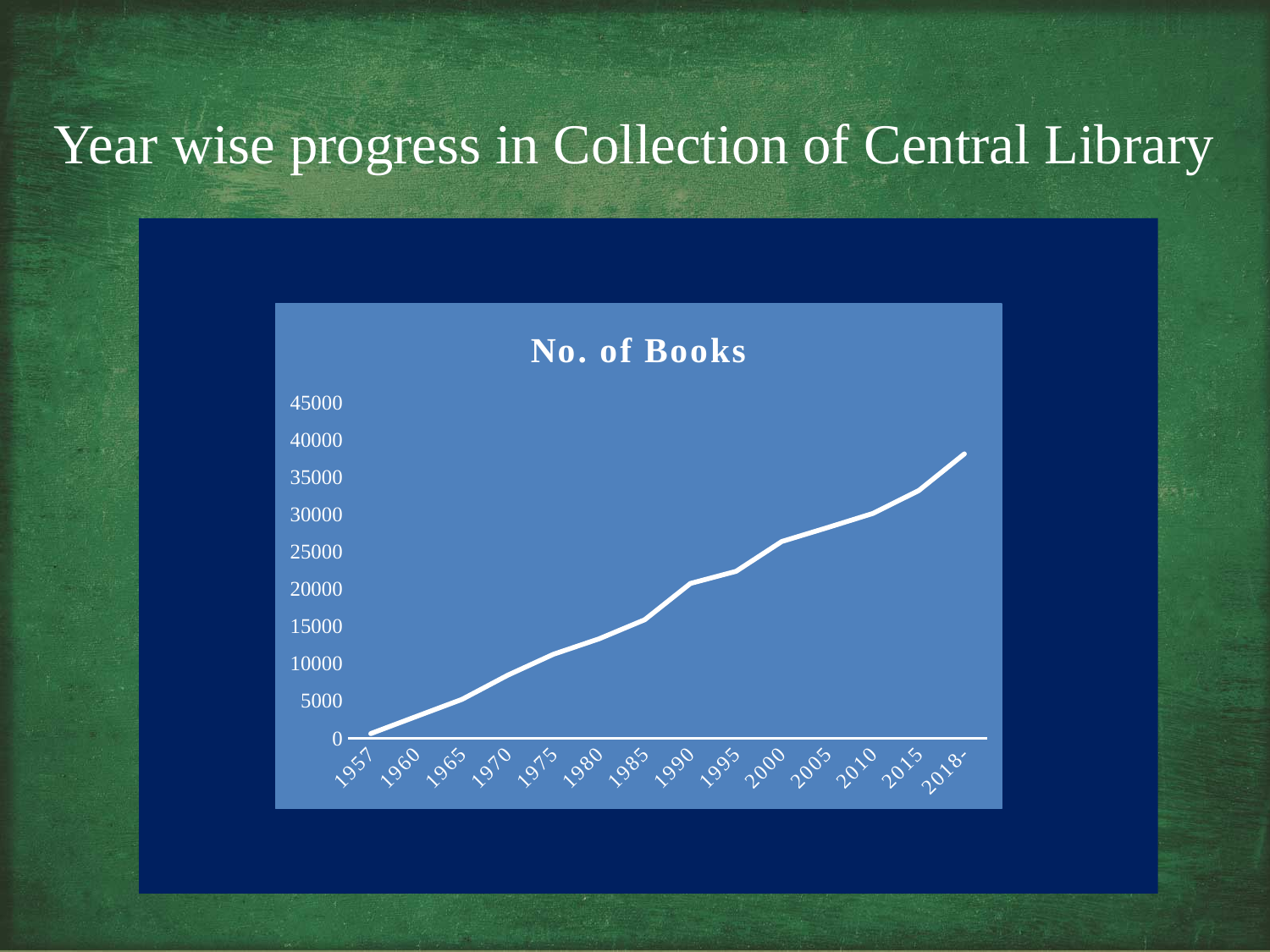
Is the value for 1957 greater or less than 5000? less What is the title of the chart? No. of Books Which year has the highest number of books? 2018- Which year has more books, 1980 or 2000? 2000 Which year has the lowest number of books? 1957 Is the value for 2018- greater or less than 35000? greater Is the value for 2015 greater or less than 30000? greater Do the values rise or fall from 1957 to 2018-? rise What kind of chart is shown on the slide? line chart How many year points are plotted along the x axis? 14